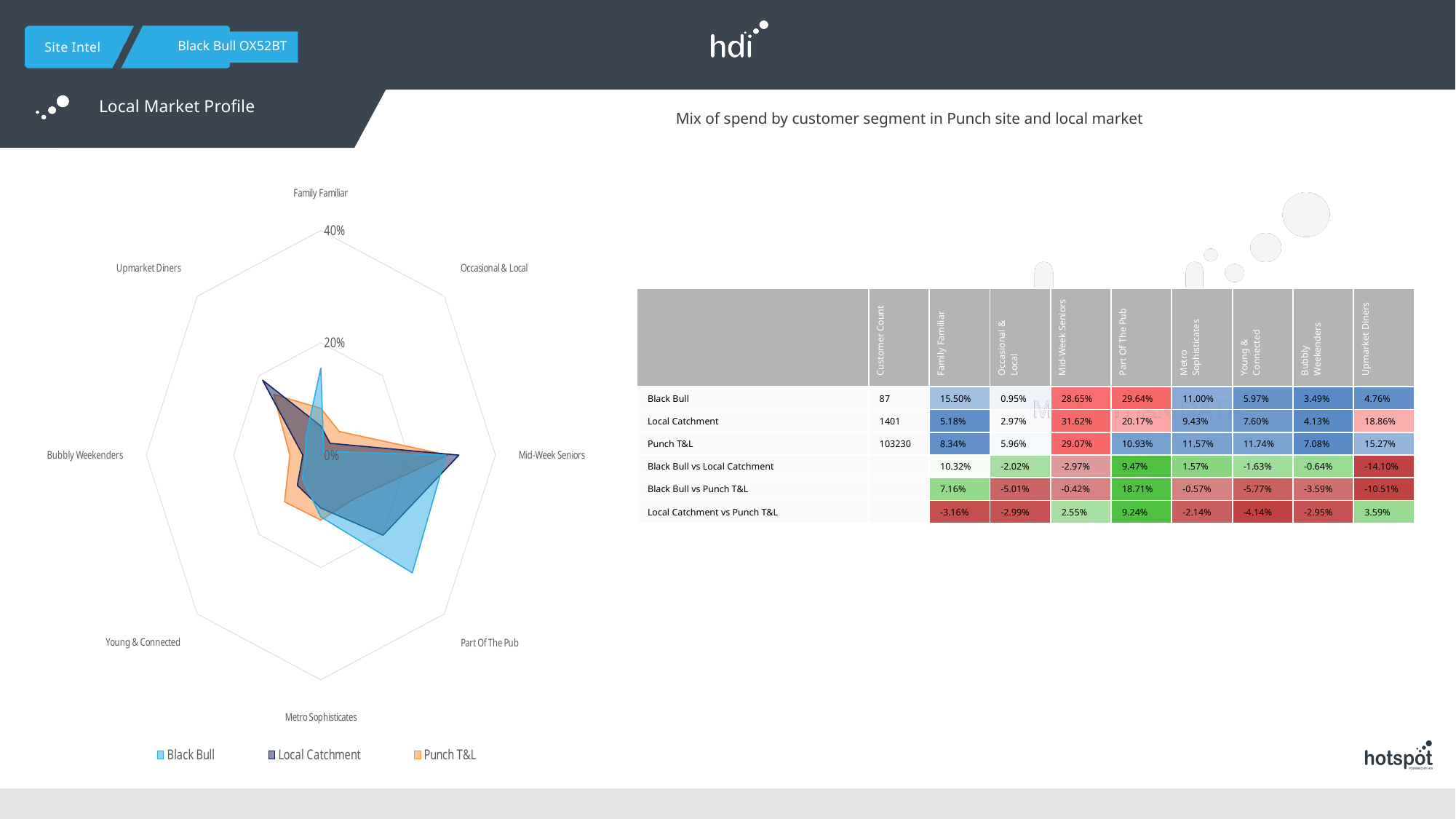
How many series does the legend of the radar chart list? 3 How many customer segments are plotted around the radar chart? 8 Is the Black Bull value for Part Of The Pub greater or less than 20%? greater What is the Punch T&L value for Mid-Week Seniors, as printed in the table? 29.07% Which segment has the highest Black Bull value according to the table? Part Of The Pub Which segment has the lowest Black Bull value? Occasional & Local For Family Familiar, which is larger: the Black Bull value or the Local Catchment value? Black Bull What kind of chart is shown on the left of the slide? Radar chart What is the Local Catchment value for Upmarket Diners, as printed in the table? 18.86% What is the Black Bull value for Part Of The Pub, as printed in the table? 29.64% What is the difference between Black Bull and Local Catchment for Family Familiar, as printed in the table? 10.32% Which series is drawn in orange on the radar chart? Punch T&L